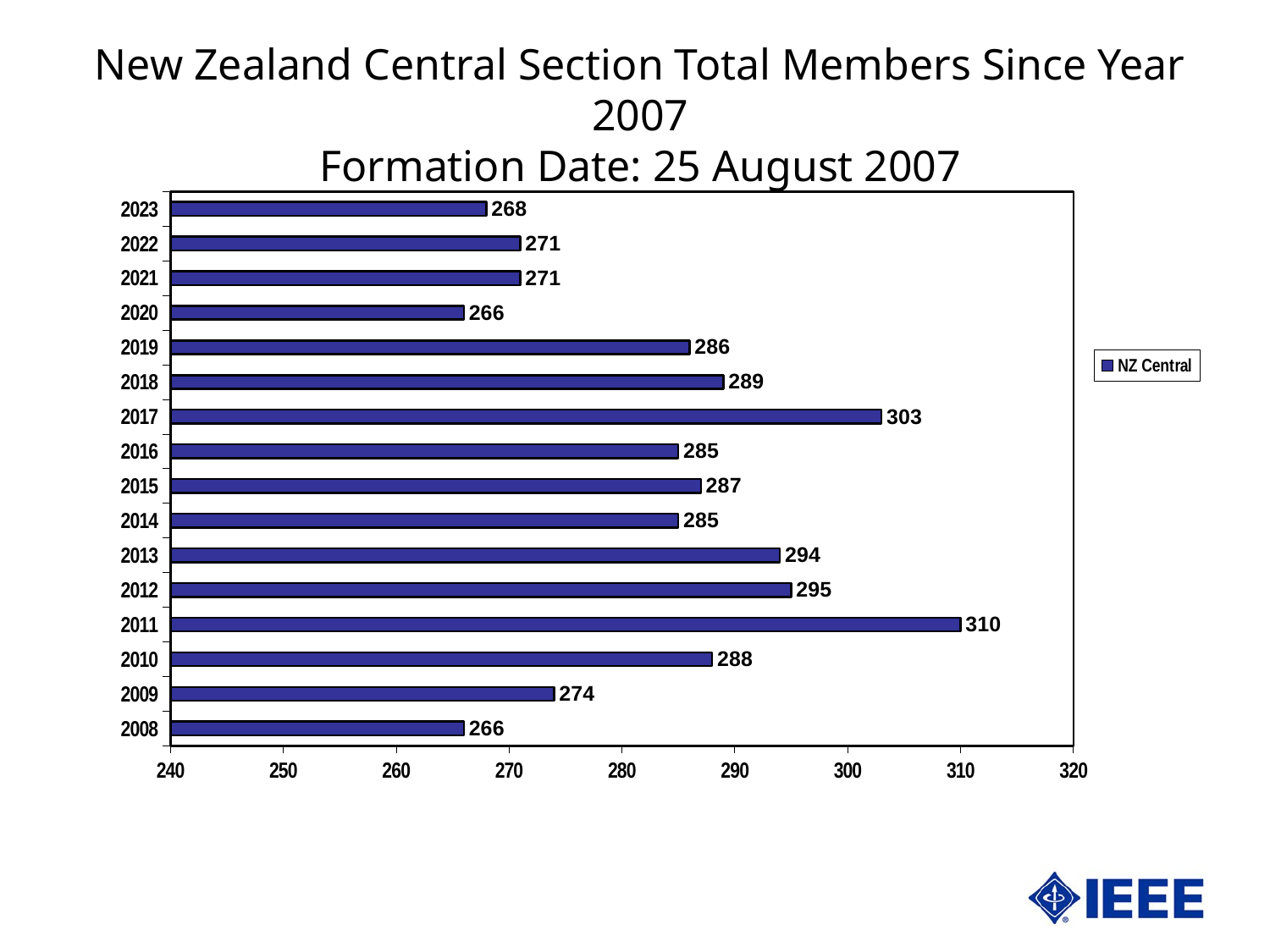
How many years are shown on the chart? 16 What was the total number of NZ Central members in 2017? 303 What is the difference in members between 2011 and 2023? 42 What kind of chart is shown on the slide? Bar chart What was the total number of NZ Central members in 2023? 268 Which year had more members, 2013 or 2019? 2013 Which year had the highest number of members? 2011 What is the name of the series shown in the legend? NZ Central Which years had the lowest number of members? 2008 and 2020 Is the value for 2010 greater or less than 280? greater How many series does the legend list? 1 What was the total number of NZ Central members in 2011? 310